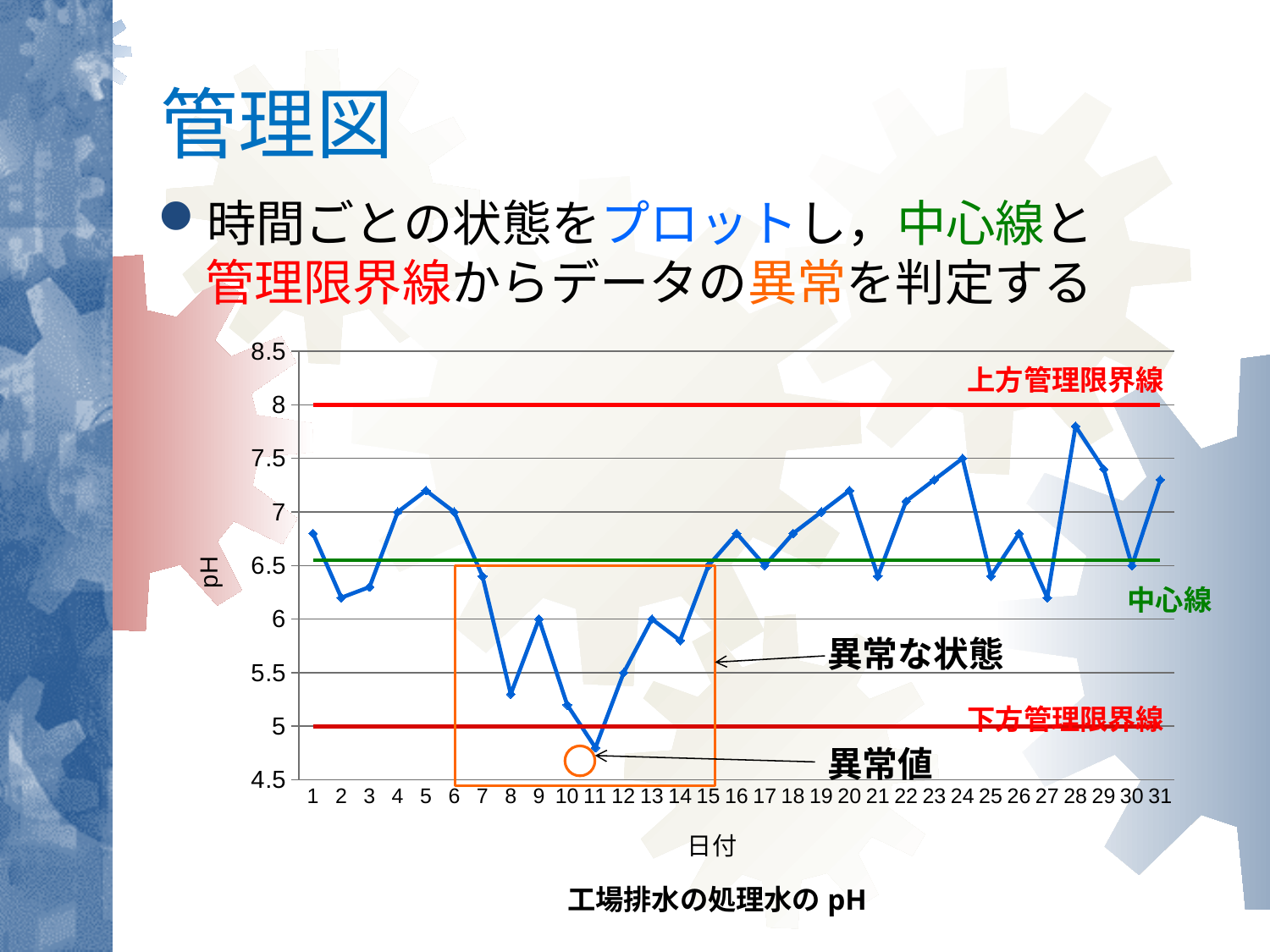
What is the title of the chart? 工場排水の処理水の pH What is the label of the x axis of the chart? 日付 Is the pH value on day 8 greater or less than 5.5? less Is the pH value on day 28 greater or less than 7.5? greater Which day has the larger pH value, day 5 or day 2? day 5 On which day is the pH value highest? 28 Is the pH value on day 11 greater or less than 5? less How many data points (days) are plotted on the chart? 31 At what pH value is the upper control limit line (上方管理限界線) drawn? 8 What kind of chart is shown on the slide? line chart At what pH value is the lower control limit line (下方管理限界線) drawn? 5 On which day is the pH value lowest? 11